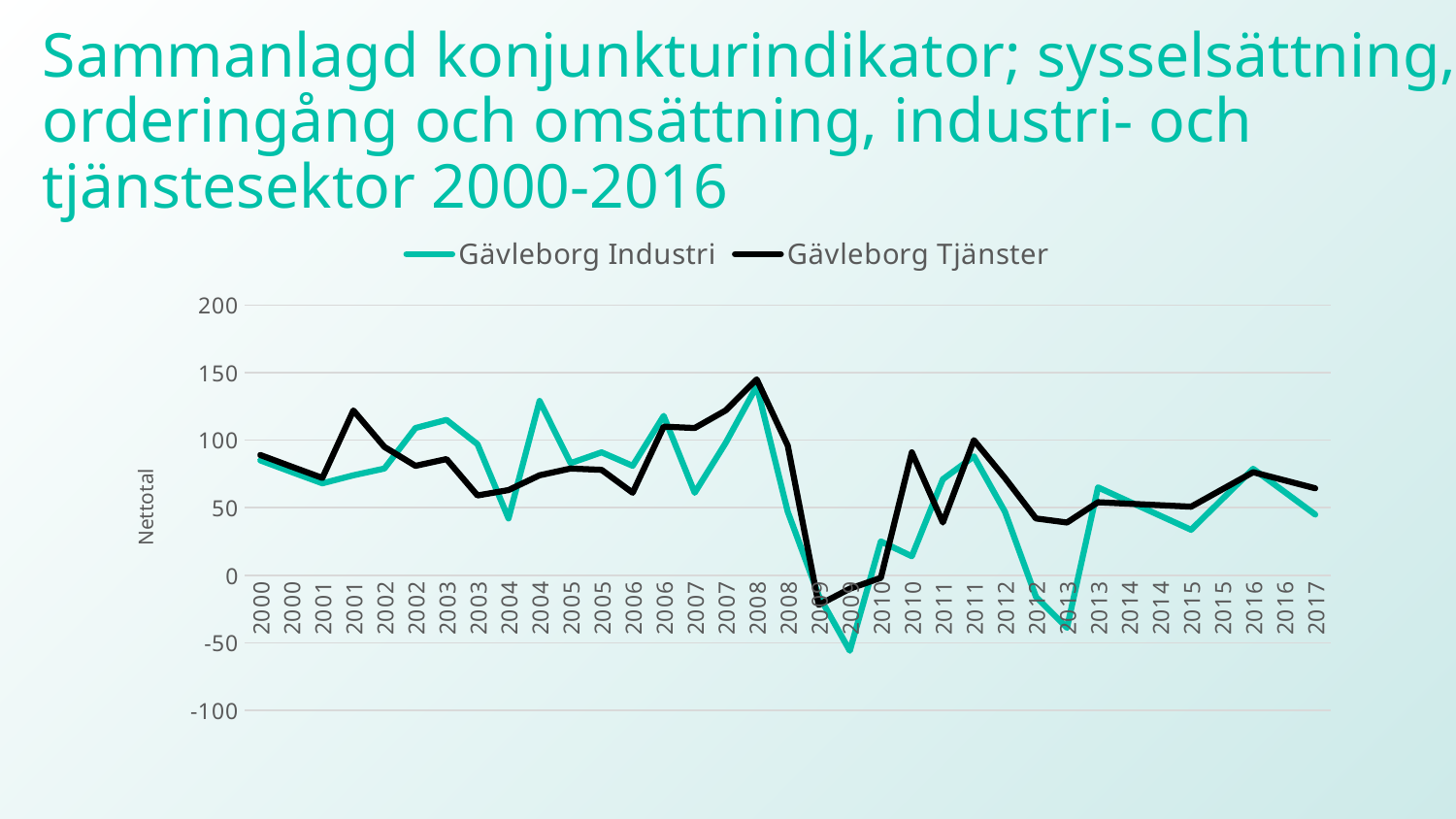
Is the peak value of Gävleborg Tjänster in 2008 greater or less than 100? greater Which series is drawn in black? Gävleborg Tjänster Do both series rise or fall between 2008 and 2009? fall At the second 2010 point, which series has the larger value, Gävleborg Industri or Gävleborg Tjänster? Gävleborg Tjänster Is the lowest value of Gävleborg Industri greater or less than 0? less Is the value for Gävleborg Tjänster at the second 2001 point greater or less than 100? greater In which year does the Gävleborg Industri line reach its lowest value? 2009 In which year does the Gävleborg Tjänster line reach its highest value? 2008 What kind of chart is shown on the slide? Line chart What is the label on the vertical axis? Nettotal At the second 2004 point, which series has the larger value, Gävleborg Industri or Gävleborg Tjänster? Gävleborg Industri How many series does the legend list? 2